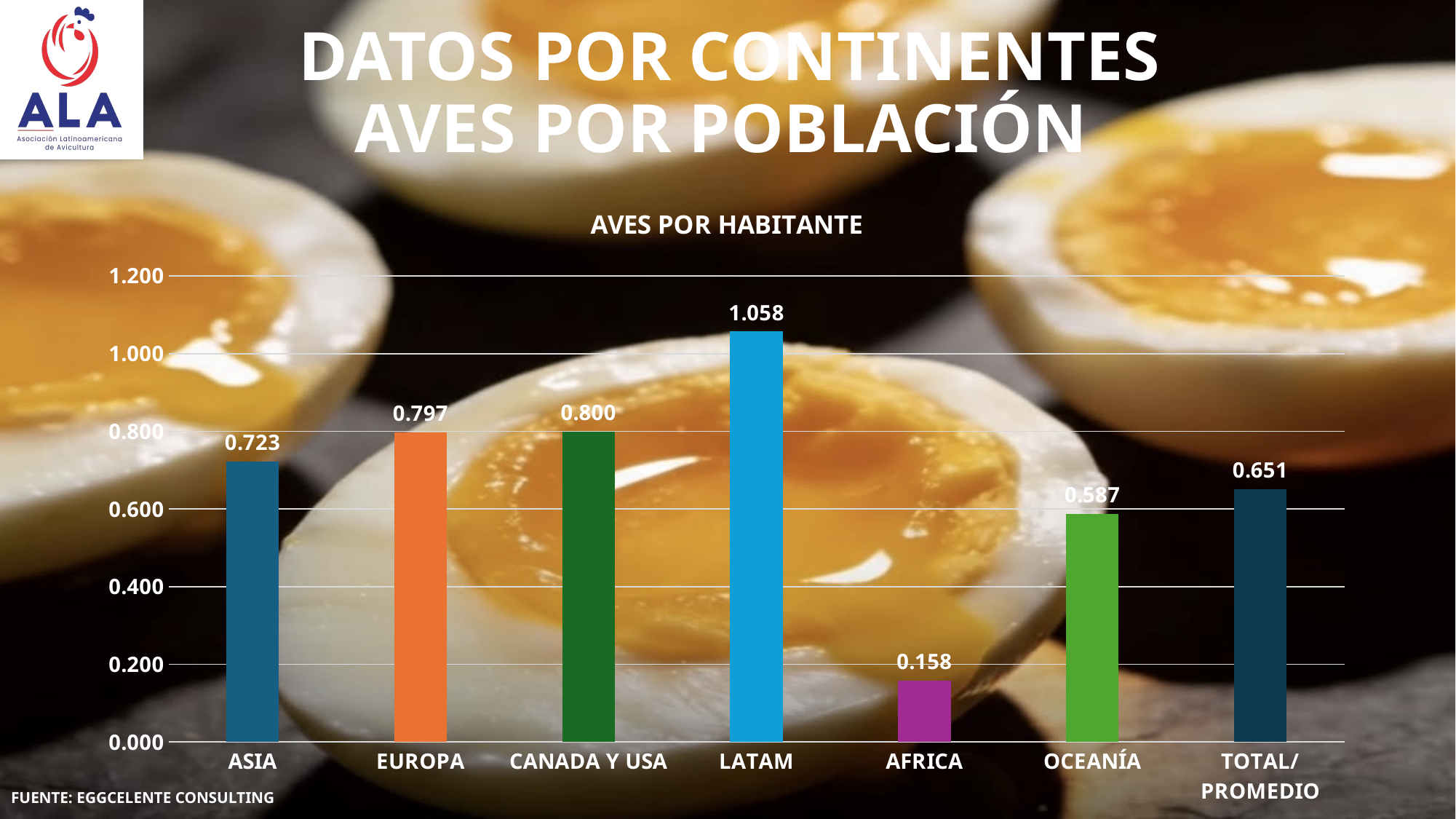
What is the value for AFRICA in the AVES POR HABITANTE chart? 0.158 What is the difference between the values for ASIA and OCEANÍA? 0.136 How many categories are shown on the x axis of the AVES POR HABITANTE chart? 7 Which category has the highest value in the AVES POR HABITANTE chart? LATAM What is the value for LATAM in the AVES POR HABITANTE chart? 1.058 What is the difference between the values for LATAM and AFRICA? 0.900 What is the value shown for TOTAL/PROMEDIO? 0.651 What is the value for OCEANÍA in the AVES POR HABITANTE chart? 0.587 Which category has the lowest value in the AVES POR HABITANTE chart? AFRICA Is the value for ASIA greater or less than 0.600? greater What kind of chart is shown on the slide? Bar chart Which is larger, the value for ASIA or the value for OCEANÍA? ASIA